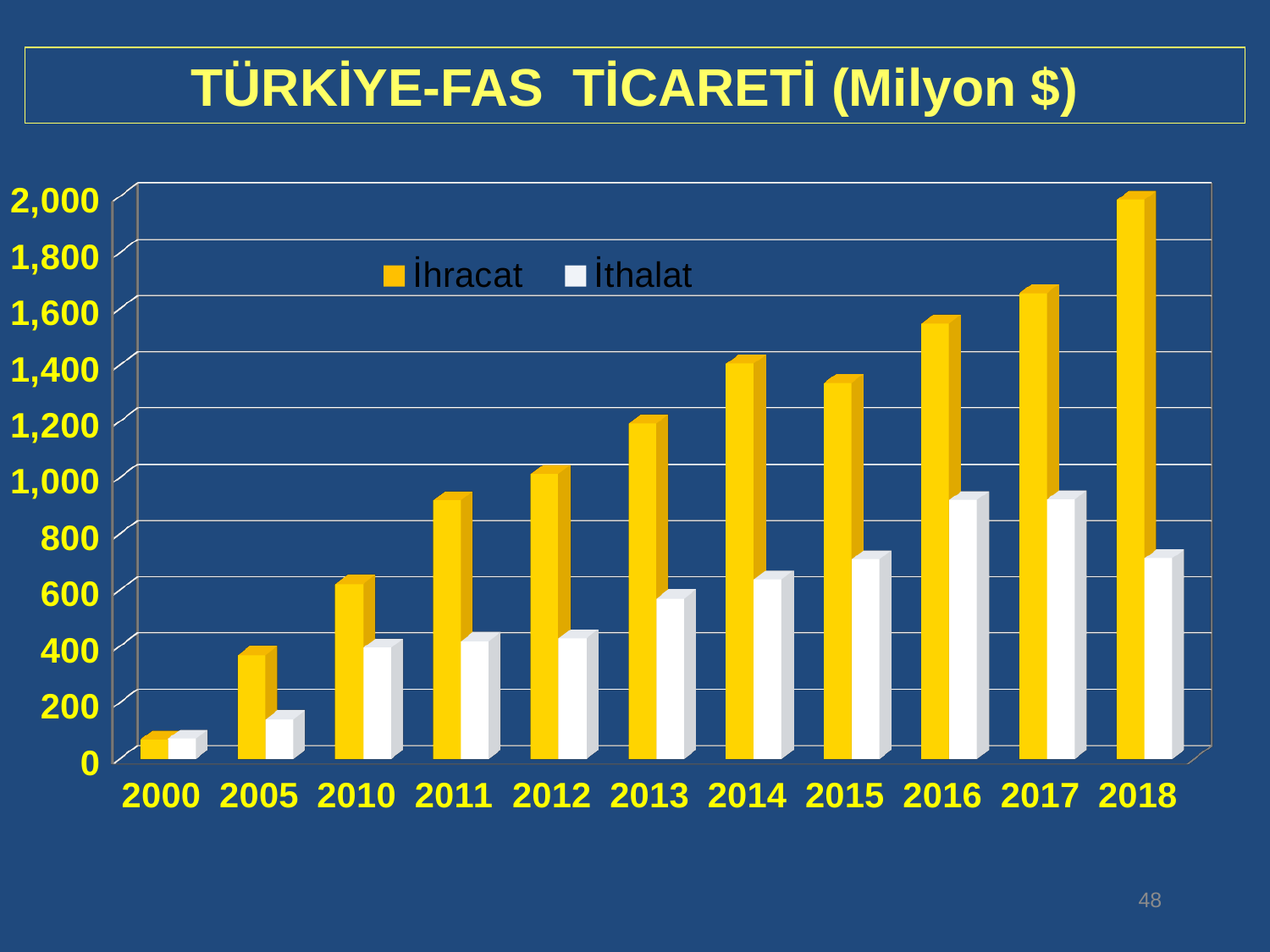
What kind of chart is shown on the slide? bar chart Is the İhracat value for 2014 greater or less than 1,200? greater Is the İhracat value for 2018 greater or less than 1,800? greater How many series does the legend list? 2 How many years are shown on the x axis? 11 What is the title of the chart? TÜRKİYE-FAS TİCARETİ (Milyon $) Is the İthalat value for 2005 greater or less than 200? less In 2018, which is larger, İhracat or İthalat? İhracat In which year is the İhracat value highest? 2018 In which year is the İthalat value lowest? 2000 In which year is the İhracat value lowest? 2000